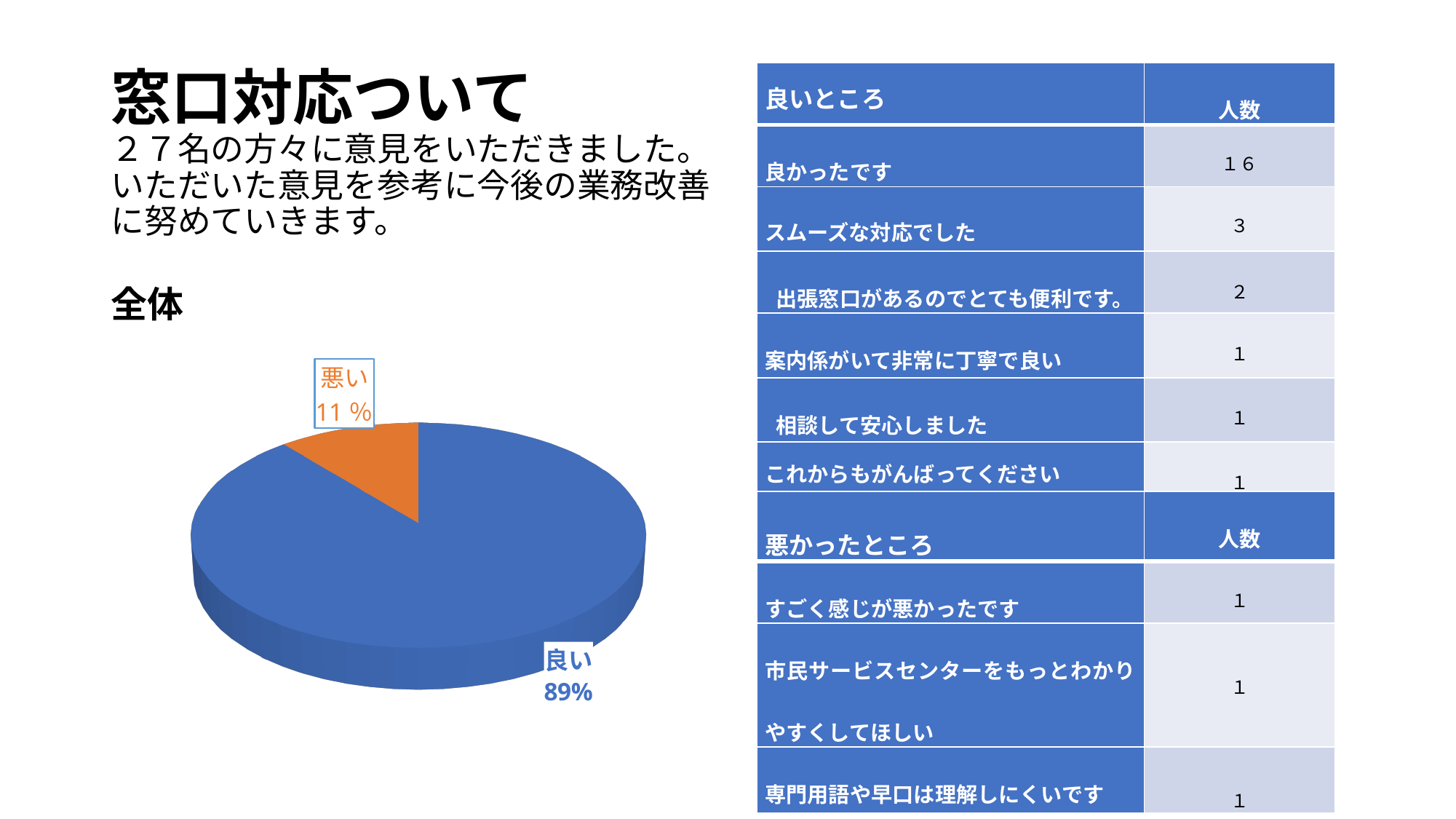
What share of the pie does 良い take up? 89% Which category has the smallest slice in the pie chart? 悪い Which is larger in the pie chart, 良い or 悪い? 良い By how many percentage points does 良い exceed 悪い in the pie chart? 78 What percentage does the 良い slice of the pie chart show? 89% Which category has the largest slice in the pie chart? 良い What kind of chart is shown on the slide? pie chart How many slices does the pie chart have? 2 What colour is the 悪い slice in the pie chart? orange What percentage does the 悪い slice of the pie chart show? 11 % What is the heading shown above the pie chart? 全体 What is the combined share of the 良い and 悪い slices? 100%